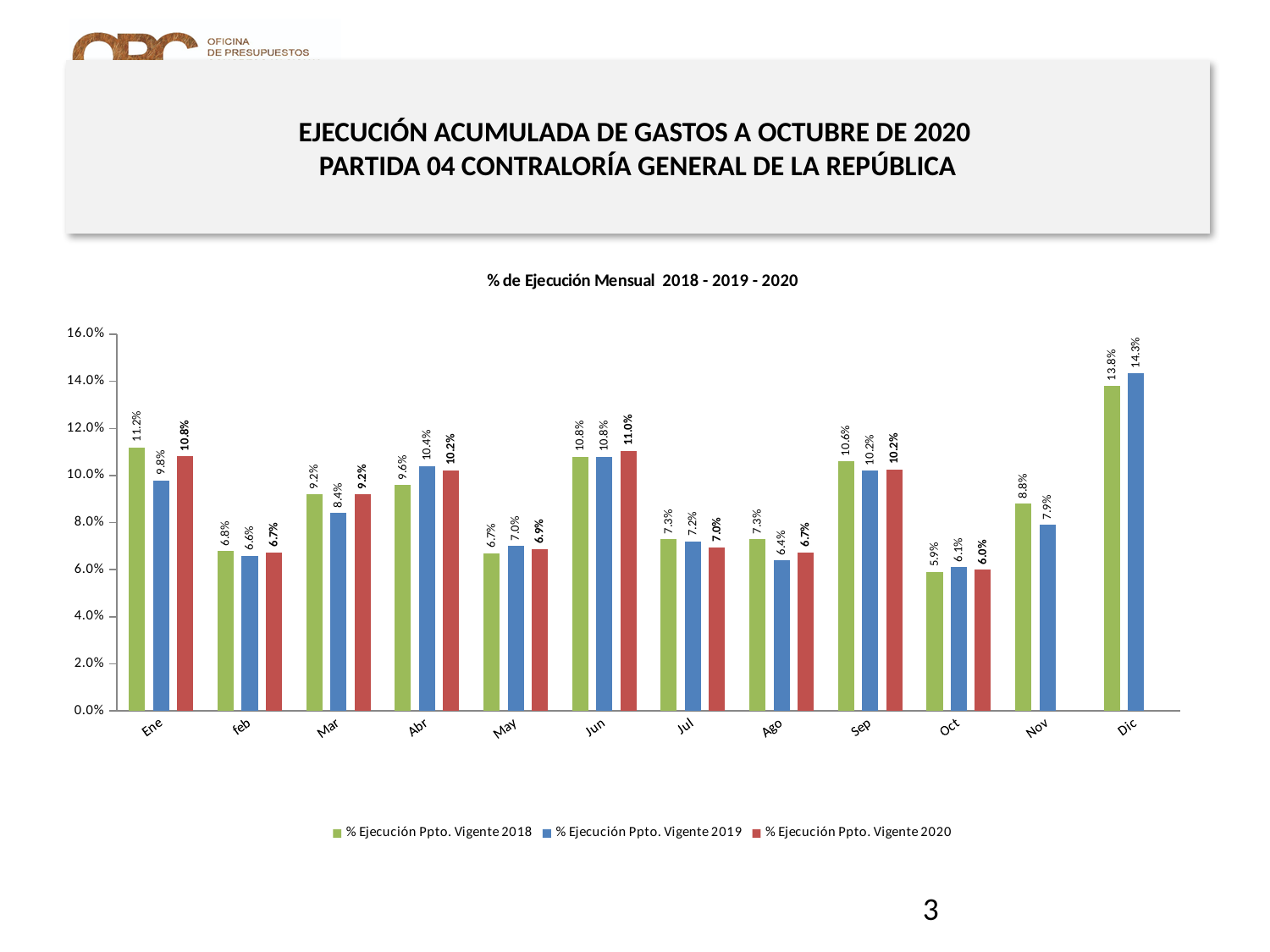
What is the title of the chart? % de Ejecución Mensual 2018 - 2019 - 2020 What is the value for % Ejecución Ppto. Vigente 2018 in Ene? 11.2% What is the value for % Ejecución Ppto. Vigente 2020 in Jun? 11.0% What is the value for % Ejecución Ppto. Vigente 2020 in Oct? 6.0% What kind of chart is shown on the slide? Bar chart How many months are shown on the x axis? 12 How many series does the legend list? 3 Which is larger in Abr: the 2018 value or the 2019 value? 2019 Which month has the highest value for % Ejecución Ppto. Vigente 2018? Dic What is the difference between the 2018 and 2019 values in Ago? 0.9% Which month has the lowest value for % Ejecución Ppto. Vigente 2019? Oct What is the value for % Ejecución Ppto. Vigente 2019 in Dic? 14.3%